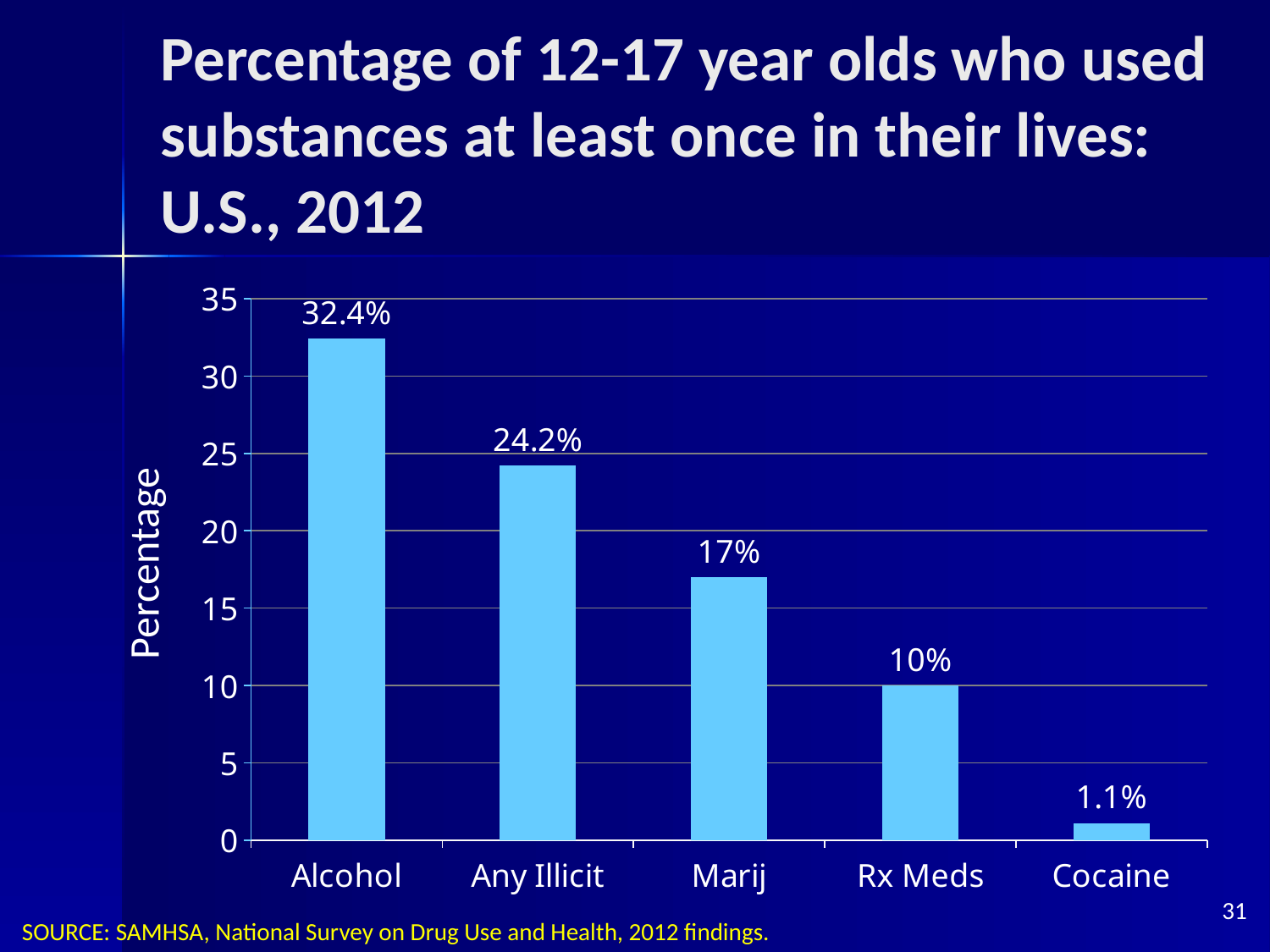
What is the difference in percentage points between Alcohol and Any Illicit? 8.2 Which substance has the highest percentage of lifetime use? Alcohol What kind of chart is shown on the slide? Bar chart What is the value shown for Marij? 17% Do the values rise or fall moving from left to right along the x axis? Fall What percentage of 12-17 year olds used alcohol at least once in their lives? 32.4% What is the value shown for Any Illicit? 24.2% What is the value shown for Cocaine? 1.1% Which is larger, the value for Marij or the value for Rx Meds? Marij What is the value shown for Rx Meds? 10% Which substance has the lowest percentage of lifetime use? Cocaine How many substance categories are shown on the x axis? 5